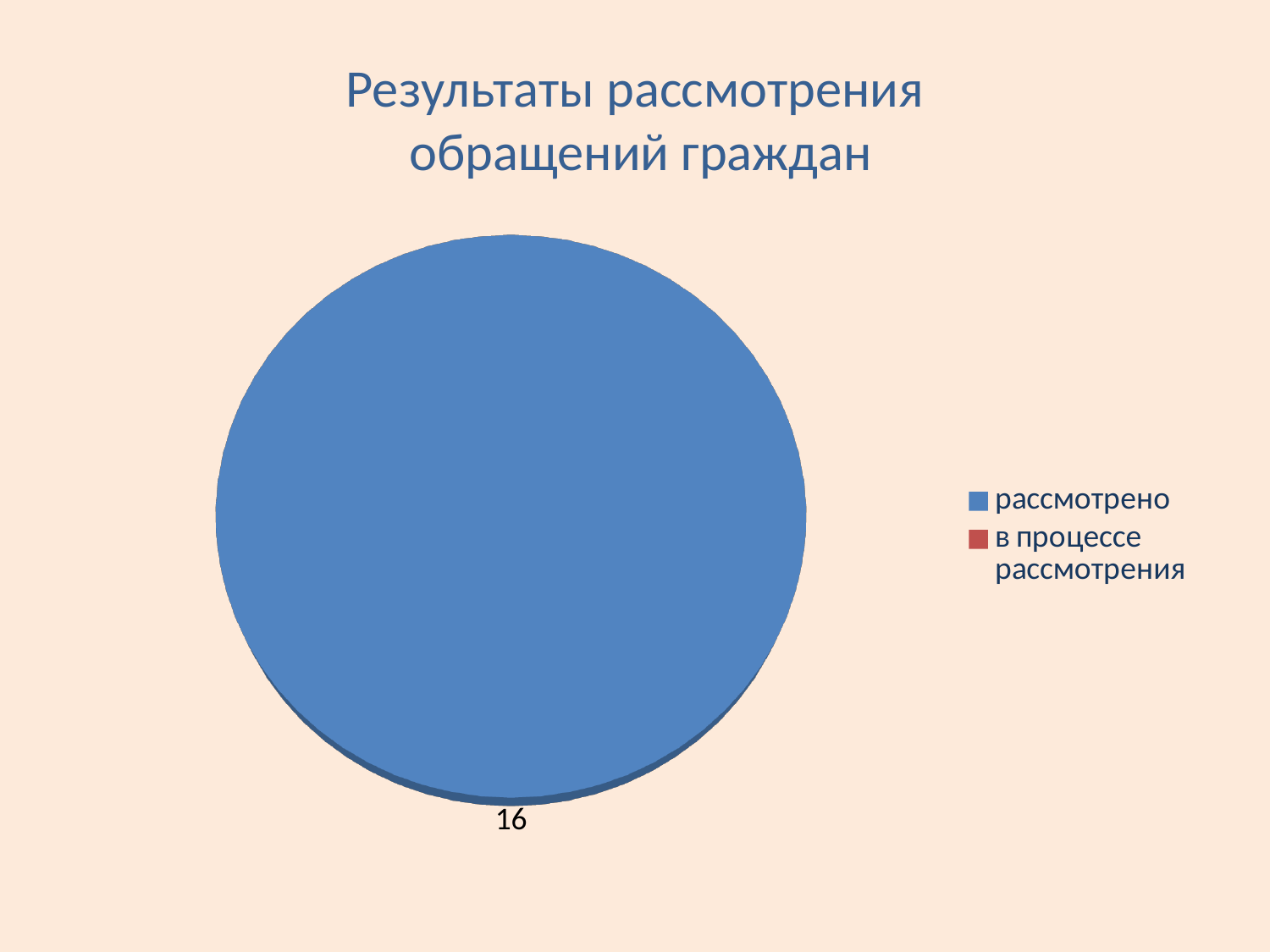
What colour represents "рассмотрено" in the legend? blue Which category is larger, "рассмотрено" or "в процессе рассмотрения"? рассмотрено What kind of chart is shown on the slide? pie chart What value is printed on the pie for "рассмотрено"? 16 How many slices are visible in the pie? 1 Which category has the largest slice of the pie? рассмотрено How many entries does the legend list? 2 What is the title of the chart? Результаты рассмотрения обращений граждан Is the value for "рассмотрено" greater or less than 10? greater